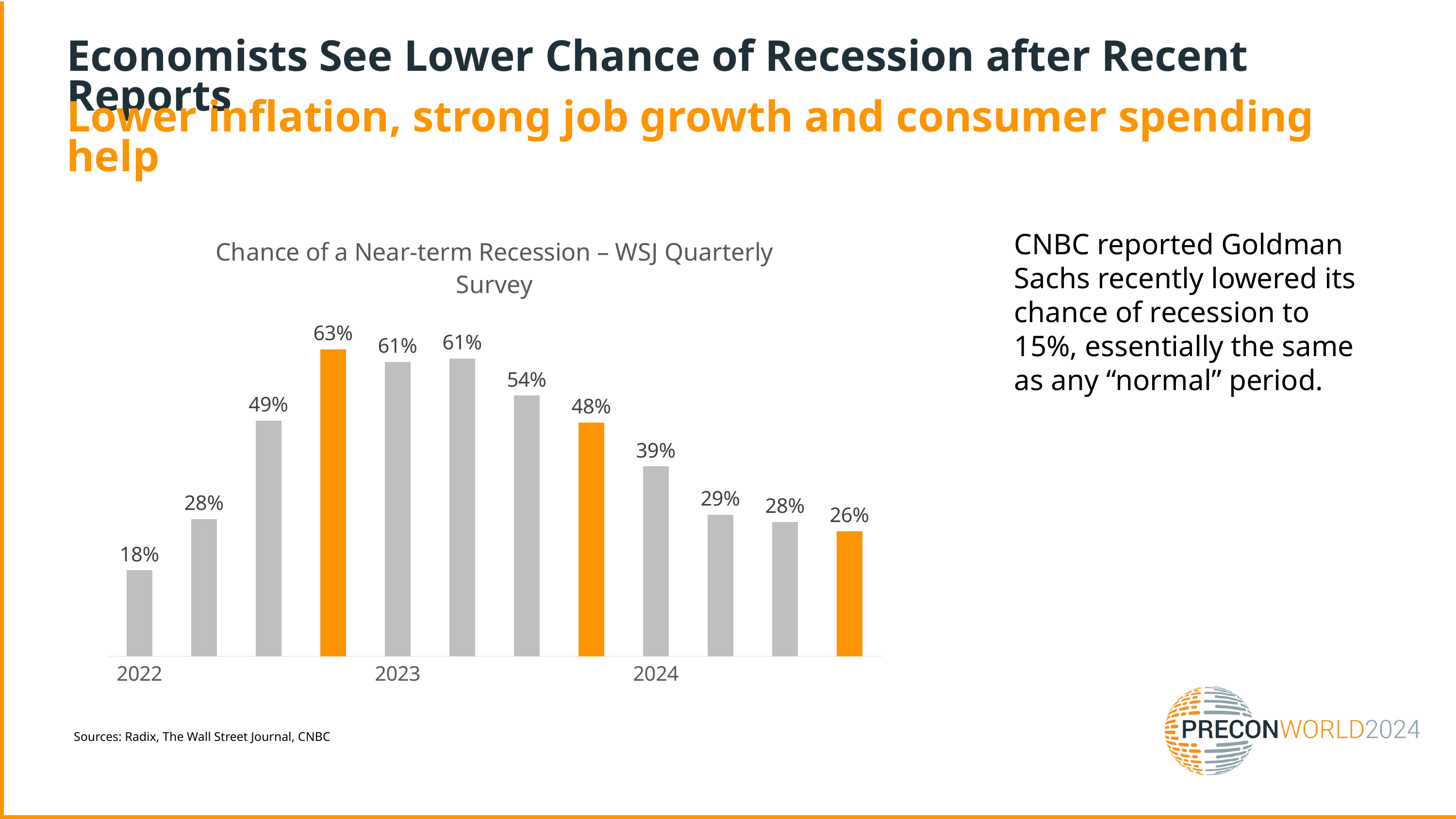
What is the value of the first bar under the 2023 label? 61% How many bars in the chart are coloured orange? 3 What is the lowest value shown in the chart? 18% What is the value of the first bar under the 2024 label? 39% What is the title of the chart? Chance of a Near-term Recession – WSJ Quarterly Survey Which is larger: the first bar of 2023 (61%) or the first bar of 2024 (39%)? the first bar of 2023 (61%) What is the value of the first bar, labelled 2022? 18% What is the highest value shown in the chart? 63% What is the difference between the highest value (63%) and the lowest value (18%)? 45% How many bars are plotted in the chart? 12 What type of chart is shown on the slide? bar chart What is the value of the last (rightmost) bar in the chart? 26%